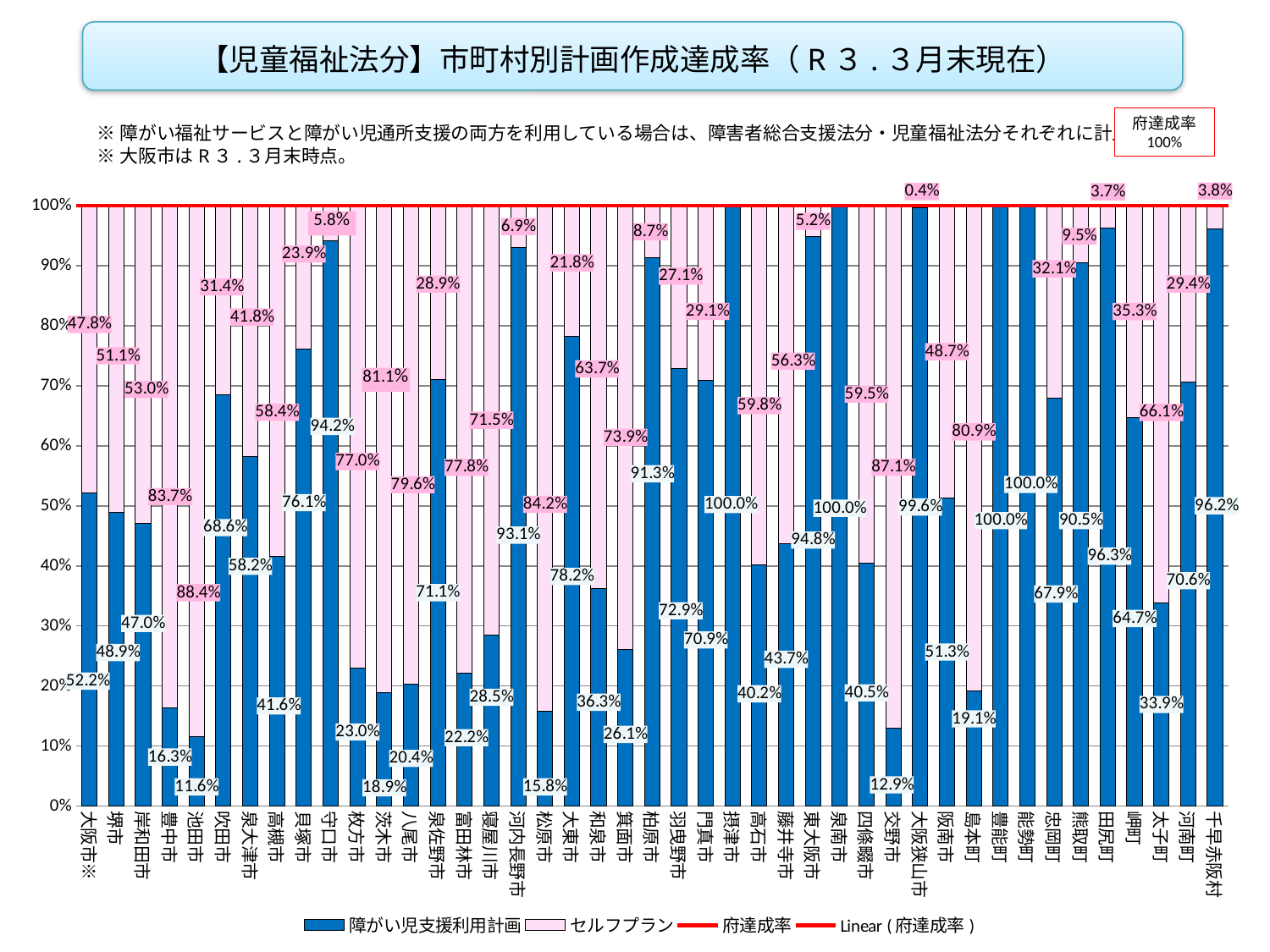
Which has a larger 障がい児支援利用計画 value, 吹田市 or 泉大津市? 吹田市 How many entries does the legend list? 4 Which municipality has the lowest 障がい児支援利用計画 value? 池田市 What is the セルフプラン value for 池田市? 88.4% Which municipality has the highest セルフプラン value? 池田市 Which municipality has the lowest セルフプラン value? 摂津市, 泉南市, 豊能町, 能勢町 (all 0%) What is the セルフプラン value for 大阪狭山市? 0.4% What is the 障がい児支援利用計画 value for 守口市? 94.2% What is the 障がい児支援利用計画 value for 大阪市※? 52.2% What kind of chart is shown on the slide? Stacked bar chart combined with a line (府達成率) What is the difference between the 障がい児支援利用計画 value and the セルフプラン value for 大阪市※? 4.4 percentage points How many municipalities are shown on the x axis? 43